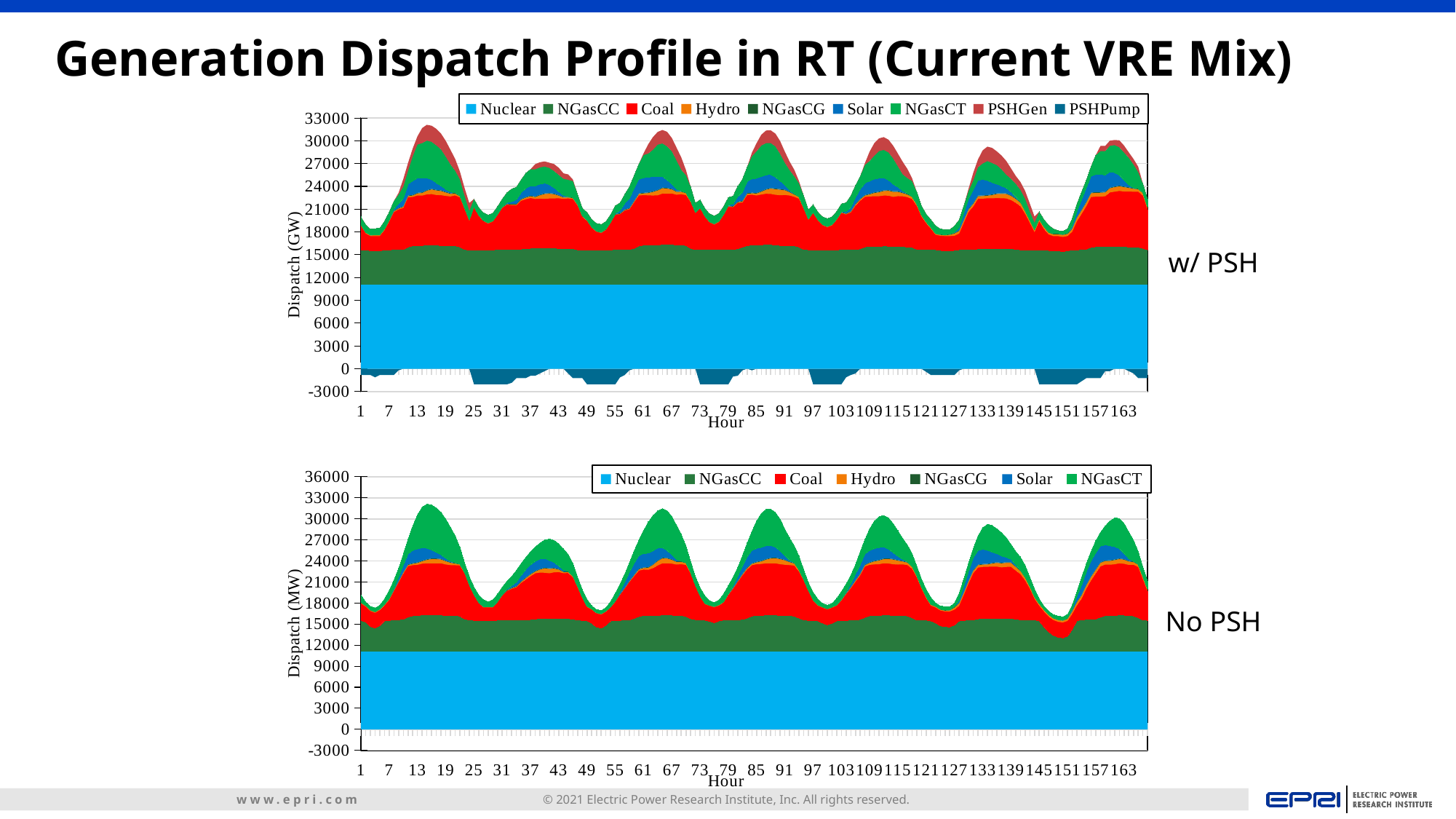
What kind of chart is the top chart labelled 'w/ PSH'? Stacked area chart How many series does the legend of the top chart (w/ PSH) list? 9 In the bottom chart (No PSH), is the Nuclear dispatch level greater or less than 12000? less In the top chart (w/ PSH), which is larger, the Nuclear band or the NGasCC band? Nuclear Which two series appear in the legend of the top chart (w/ PSH) but not in the legend of the bottom chart (No PSH)? PSHGen and PSHPump In the bottom chart (No PSH), which series forms the largest band of dispatch? Nuclear In the top chart (w/ PSH), are the PSHPump values greater or less than 0? less In the top chart (w/ PSH), is the Nuclear dispatch level greater or less than 9000? greater How many series does the legend of the bottom chart (No PSH) list? 7 What is the x-axis label of the top chart (w/ PSH)? Hour What is the y-axis label of the bottom chart (No PSH)? Dispatch (MW)